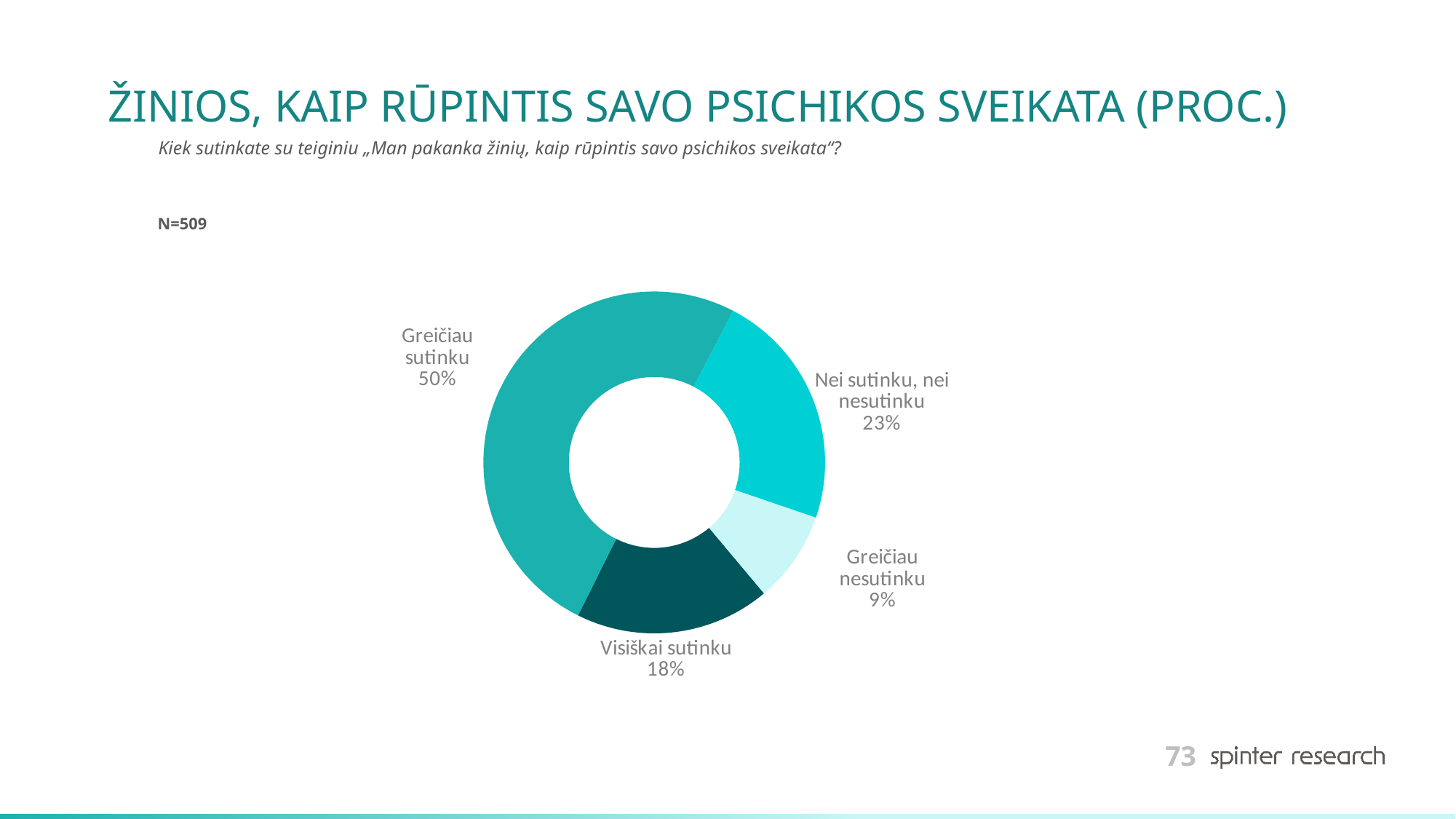
What percentage of respondents answered "Greičiau nesutinku"? 9% Which response category has the largest share of the chart? Greičiau sutinku What kind of chart is shown on the slide? Doughnut (pie) chart What percentage of respondents answered "Visiškai sutinku"? 18% Which is larger: the share for "Visiškai sutinku" or the share for "Nei sutinku, nei nesutinku"? Nei sutinku, nei nesutinku What percentage of respondents answered "Greičiau sutinku"? 50% What is the difference in percentage points between "Visiškai sutinku" and "Greičiau nesutinku"? 9 What percentage of respondents answered "Nei sutinku, nei nesutinku"? 23% What is the difference in percentage points between "Greičiau sutinku" and "Nei sutinku, nei nesutinku"? 27 How many response categories are shown in the chart? 4 Which response category has the smallest share of the chart? Greičiau nesutinku What is the sample size (N) stated on the slide? N=509